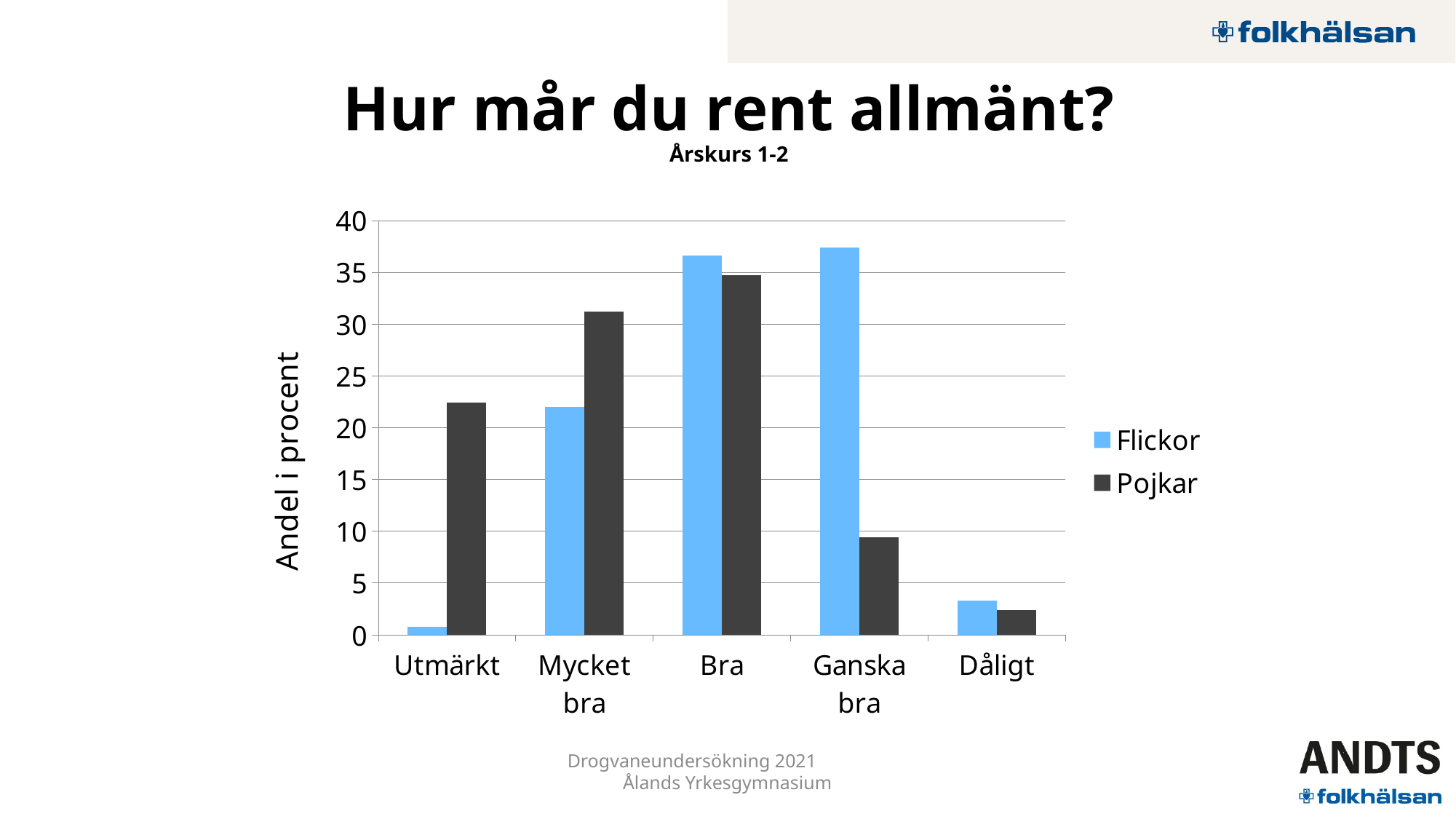
What is the label of the y axis? Andel i procent How many categories are shown on the x axis? 5 What kind of chart is shown on the slide? bar chart For Utmärkt, which is larger: Flickor or Pojkar? Pojkar For Ganska bra, which is larger: Flickor or Pojkar? Flickor Is the value for Flickor in Ganska bra greater or less than 35? greater Which category has the lowest value for Flickor? Utmärkt Which category has the lowest value for Pojkar? Dåligt Which category has the highest value for Pojkar? Bra How many series does the legend list? 2 For Mycket bra, which is larger: Flickor or Pojkar? Pojkar Is the value for Pojkar in Utmärkt greater or less than 20? greater